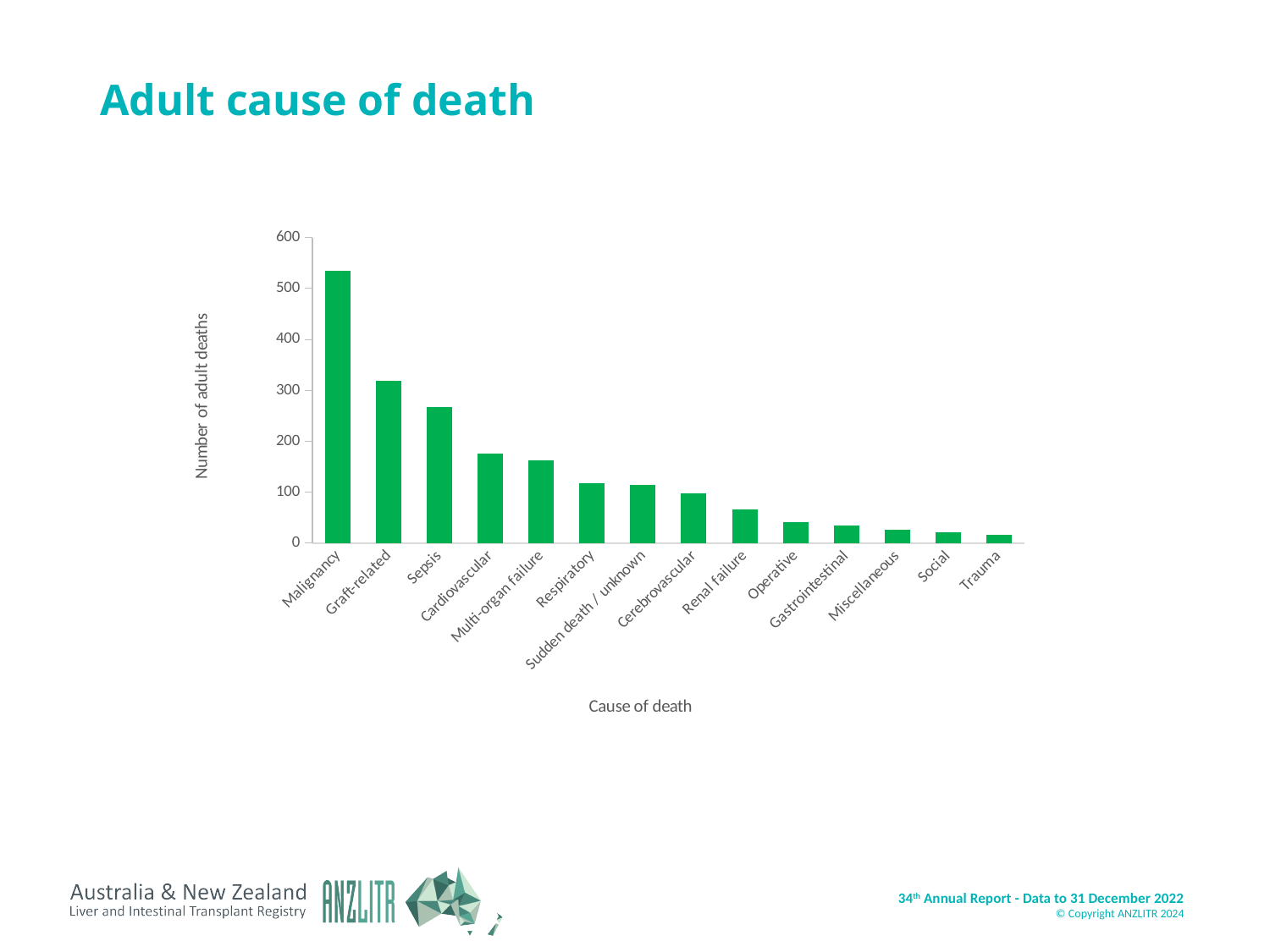
Which cause of death has the highest number of adult deaths? Malignancy Is the value for Graft-related greater or less than 300? greater Which cause of death has the lowest number of adult deaths? Trauma How many causes of death are shown on the x axis? 14 Which has more adult deaths, Sepsis or Cardiovascular? Sepsis What kind of chart is shown on the slide? bar chart What is the label of the y axis? Number of adult deaths Is the value for Sepsis greater or less than 300? less Do the values rise or fall moving from left to right along the x axis? fall Is the value for Malignancy greater or less than 500? greater